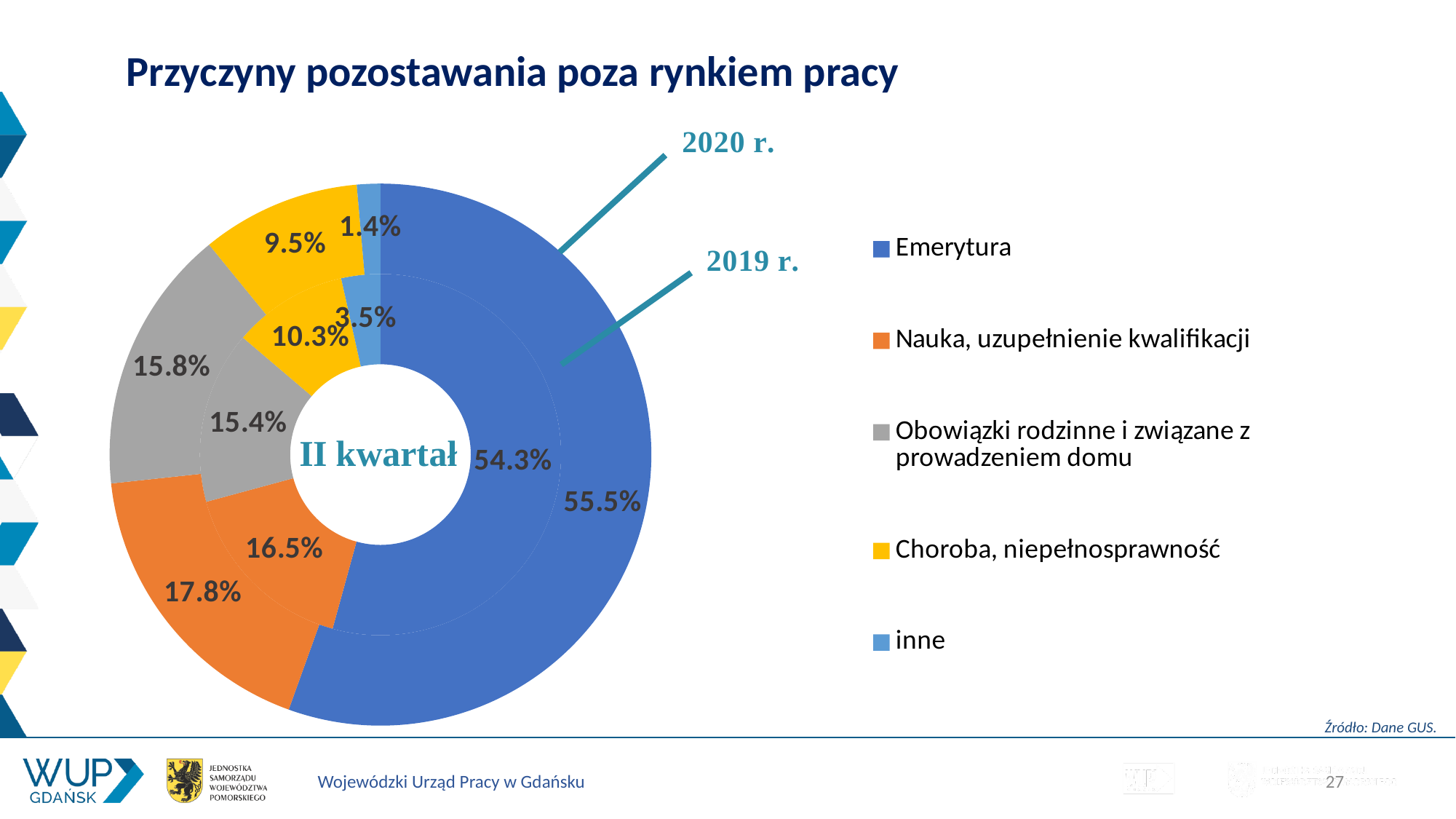
Which category has the largest share in the 2020 r. ring? Emerytura Which is larger: the share of Obowiązki rodzinne i związane z prowadzeniem domu in 2020 r. or in 2019 r.? 2020 r. What share does Emerytura have in the 2020 r. (outer) ring? 55.5% What is the title of the chart on the slide? Przyczyny pozostawania poza rynkiem pracy What kind of chart is shown on the slide? Doughnut (pie) chart What is the value for inne in 2020 r.? 1.4% By how many percentage points did the share of inne change from 2019 r. (3.5%) to 2020 r. (1.4%)? 2.1 percentage points What is the value for Choroba, niepełnosprawność in 2019 r.? 10.3% How many categories does the legend list? 5 What is the value for Nauka, uzupełnienie kwalifikacji in 2020 r.? 17.8% What share does Emerytura have in the 2019 r. (inner) ring? 54.3% Which category has the smallest share in the 2019 r. ring? inne